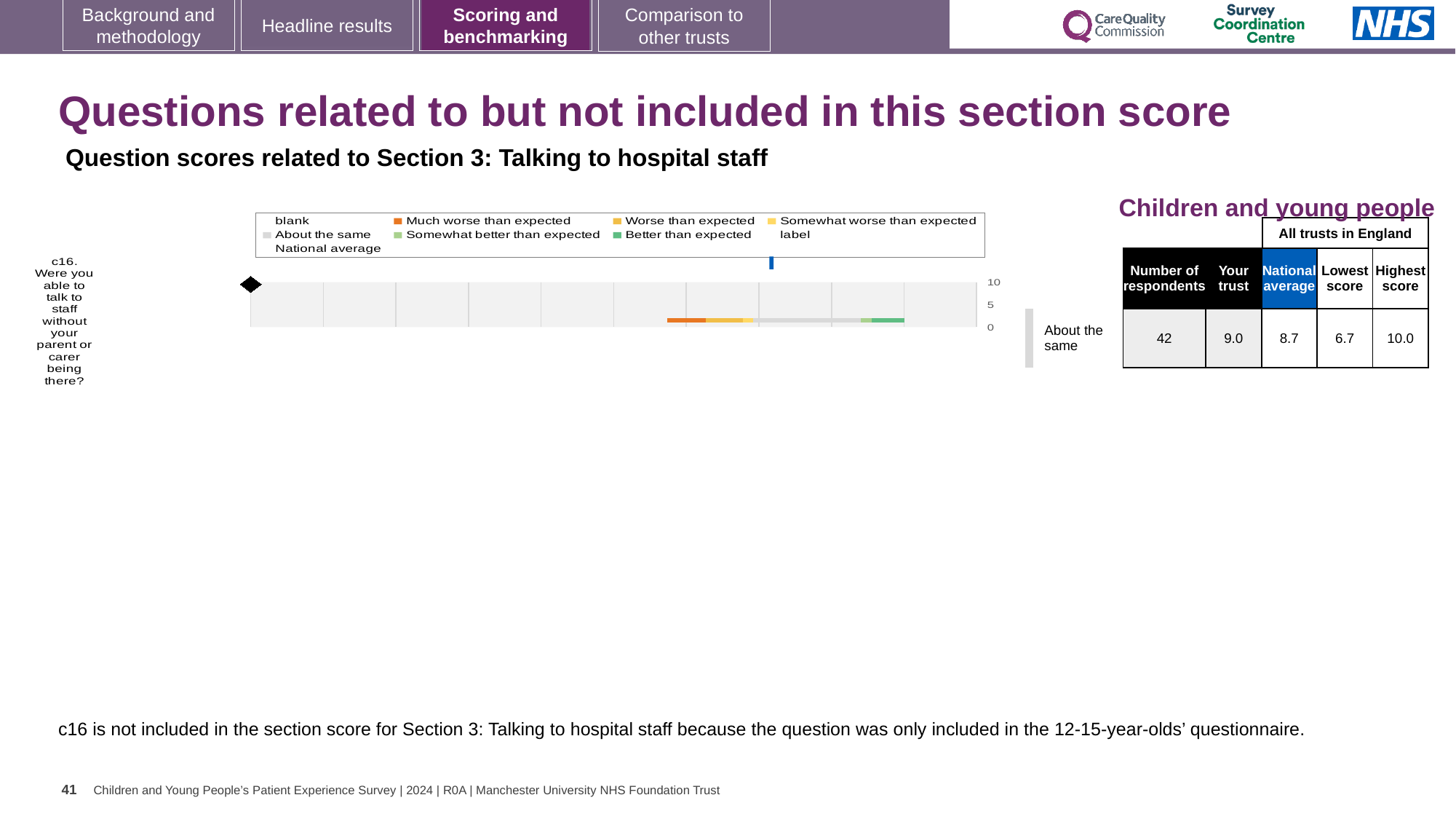
What is the difference between the highest and lowest scores for c16 across all trusts in England? 3.3 What is the national average score for c16? 8.7 Which is higher for c16: the trust's score or the national average? Your trust What is the difference between the trust's score and the national average for c16? 0.3 What is the highest score among all trusts in England for c16? 10.0 What kind of chart is shown for question c16? bar chart Which question is plotted in the chart? c16. Were you able to talk to staff without your parent or carer being there? What is the lowest score among all trusts in England for c16? 6.7 What is the 'Your trust' score for c16? 9.0 How many respondents answered c16? 42 How many survey questions are plotted in the chart? 1 What benchmark category is shown for c16 next to the chart? About the same